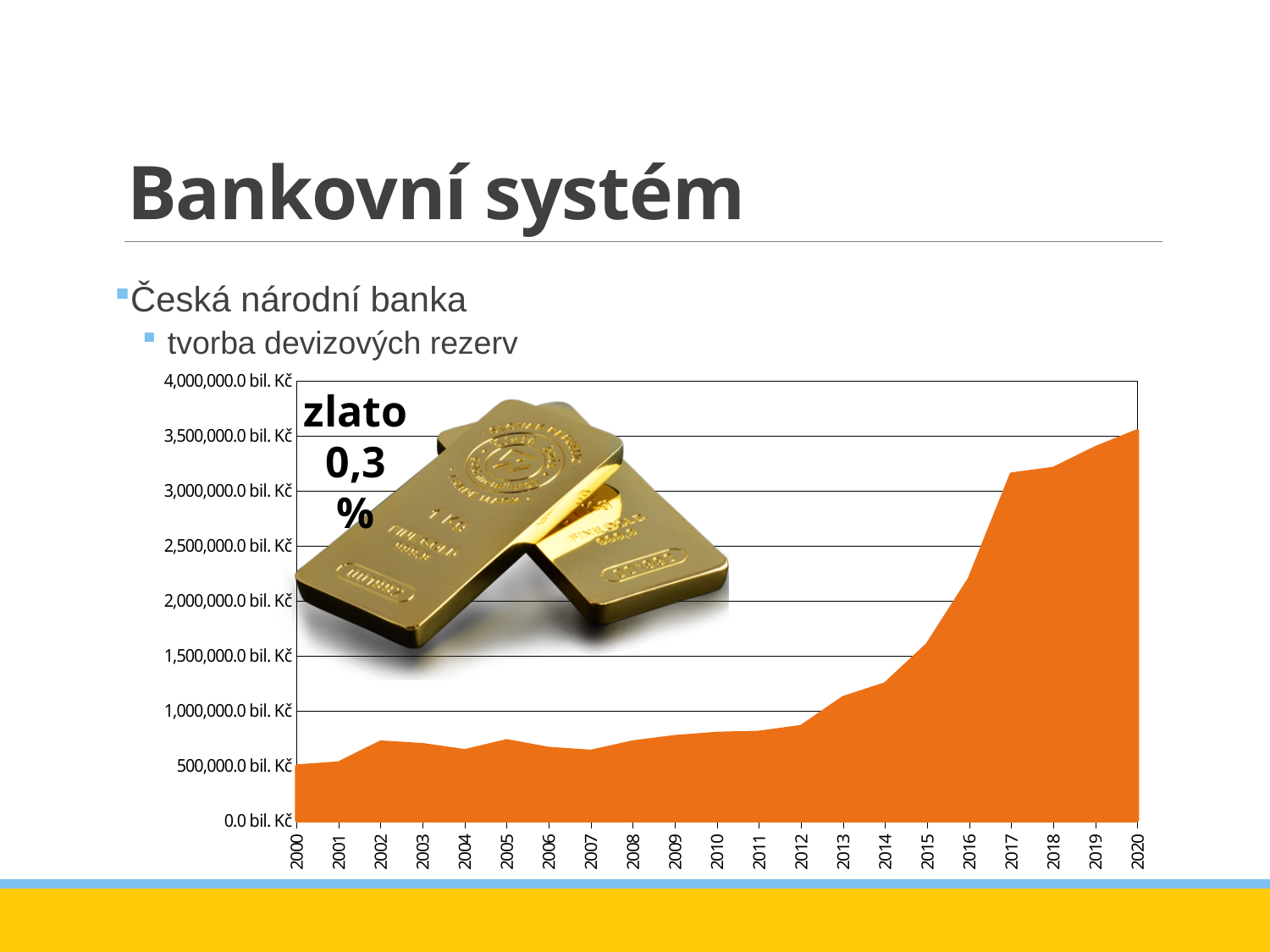
Is the value for 2020 greater or less than 3,000,000.0 bil. Kč? greater Which year has the larger value, 2010 or 2020? 2020 Is the value for 2015 greater or less than 1,000,000.0 bil. Kč? greater What is the last year shown on the x axis of the chart? 2020 What text is written in bold over the gold bars image in the chart? zlato 0,3 % What is the first year shown on the x axis of the chart? 2000 Which year has the lowest value in the chart? 2000 Do the values in the chart generally rise or fall from 2000 to 2020? rise Is the value for 2012 greater or less than 1,000,000.0 bil. Kč? less What kind of chart is shown on the slide? area chart Which year has the highest value in the chart? 2020 How many years are plotted along the x axis of the chart? 21